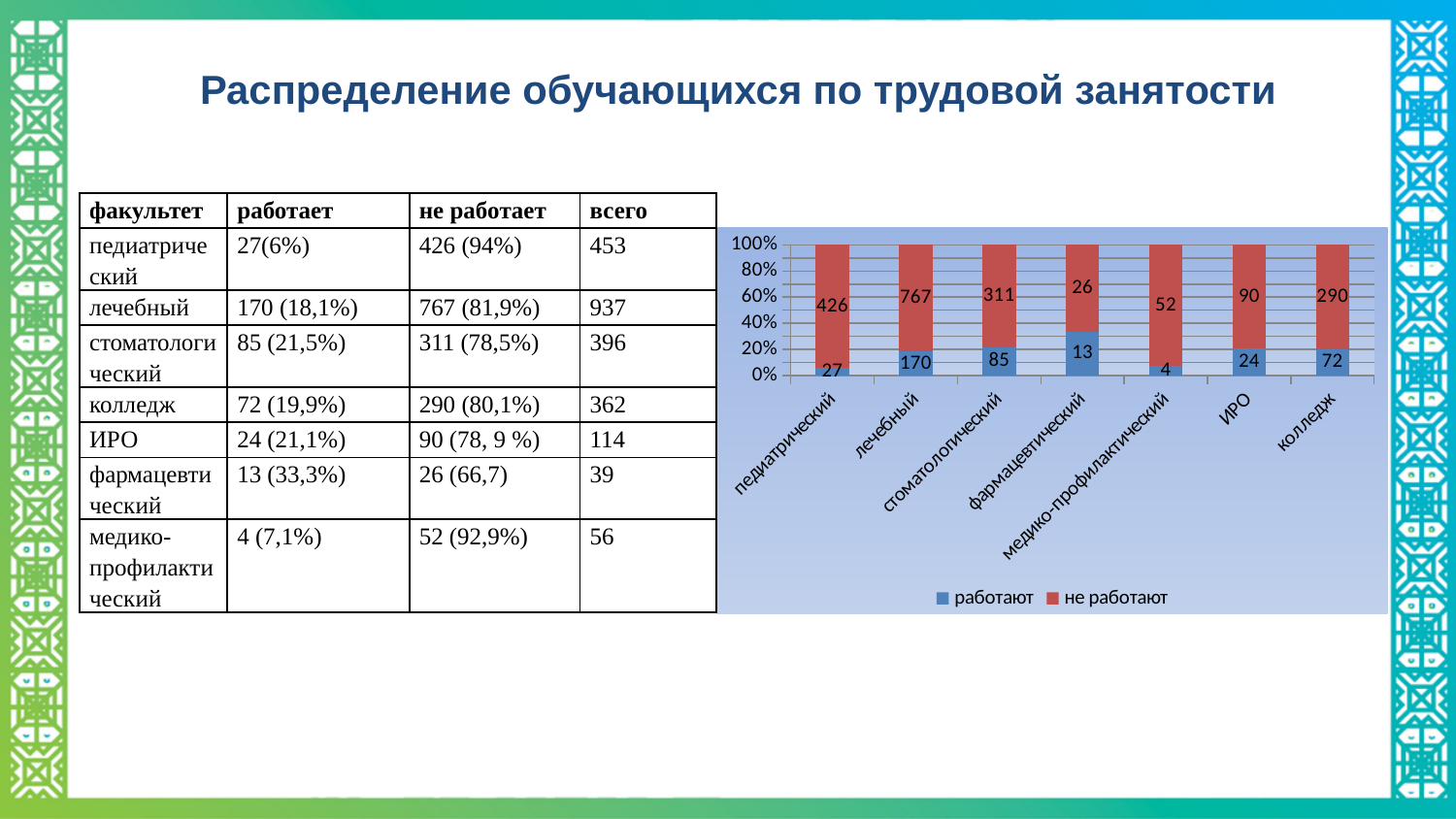
What is the value of "не работают" for стоматологический in the chart? 311 Which faculty has the lowest value for "работают" in the chart? медико-профилактический What is the difference between the "не работают" values for педиатрический and колледж? 136 What is the total of the two labelled values in the bar for ИРО? 114 Which faculty has the highest value for "не работают" in the chart? лечебный Is the share of the "работают" segment in the фармацевтический bar greater or less than 20%? greater How many series does the chart legend list? 2 What is the value of "работают" for медико-профилактический in the chart? 4 How many faculties (categories) are shown on the x axis of the chart? 7 What is the value of "работают" for лечебный in the chart? 170 What type of chart is shown on the slide? bar chart Which is larger: the "работают" value for стоматологический or for колледж? стоматологический